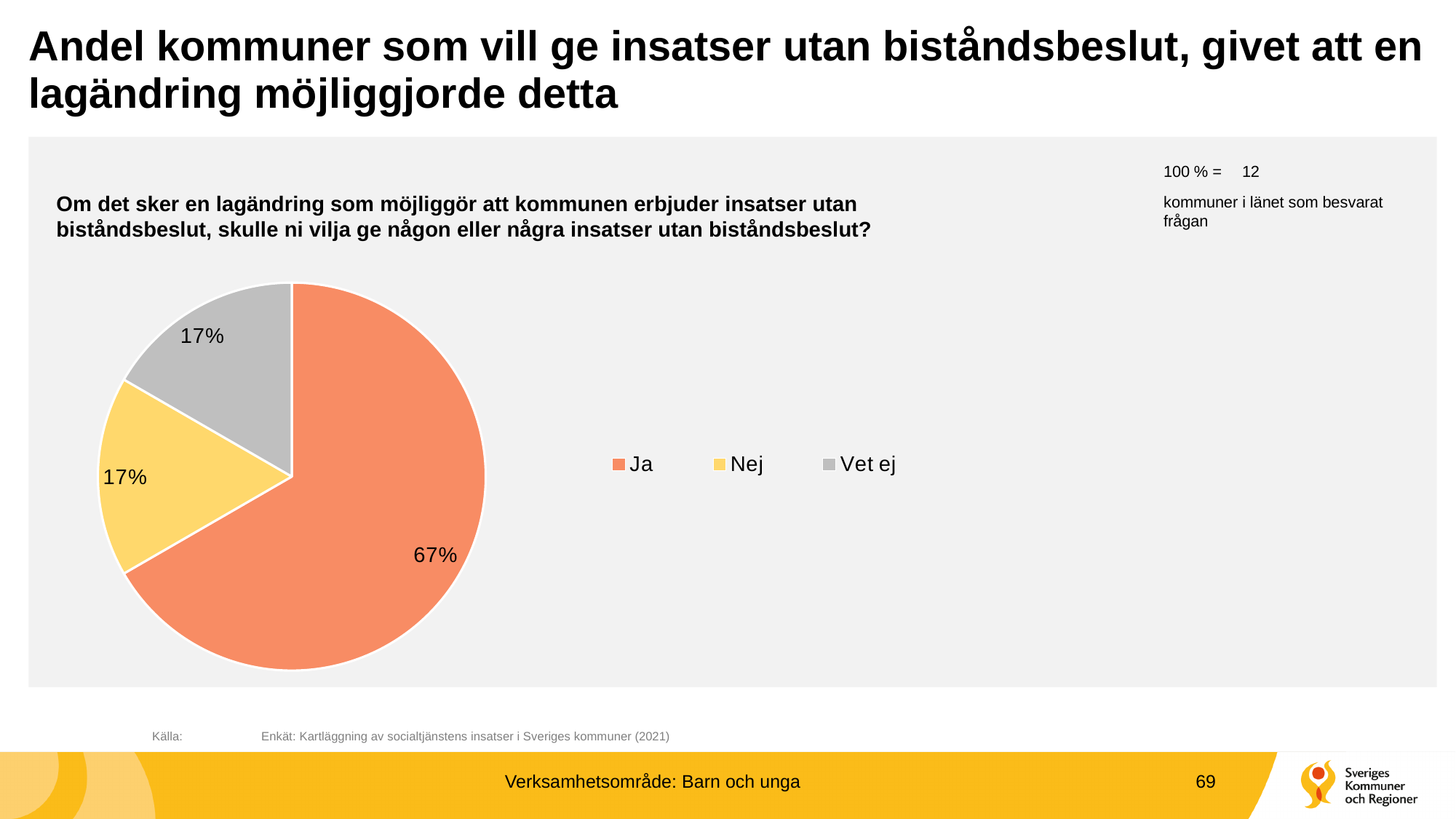
What share of the pie does "Ja" represent? 67% How many entries does the legend list? 3 What is the difference in percentage points between the "Ja" slice and the "Nej" slice? 50 Is the value for "Ja" greater or less than 50%? greater How many slices does the pie chart have? 3 What colour is the "Nej" slice in the pie chart? yellow What share of the pie does "Vet ej" represent? 17% What share of the pie does "Nej" represent? 17% What kind of chart is shown on the slide? pie chart Which category has the largest slice of the pie? Ja According to the note on the slide, how many municipalities does 100% correspond to? 12 Which is larger, the "Ja" slice or the "Vet ej" slice? Ja